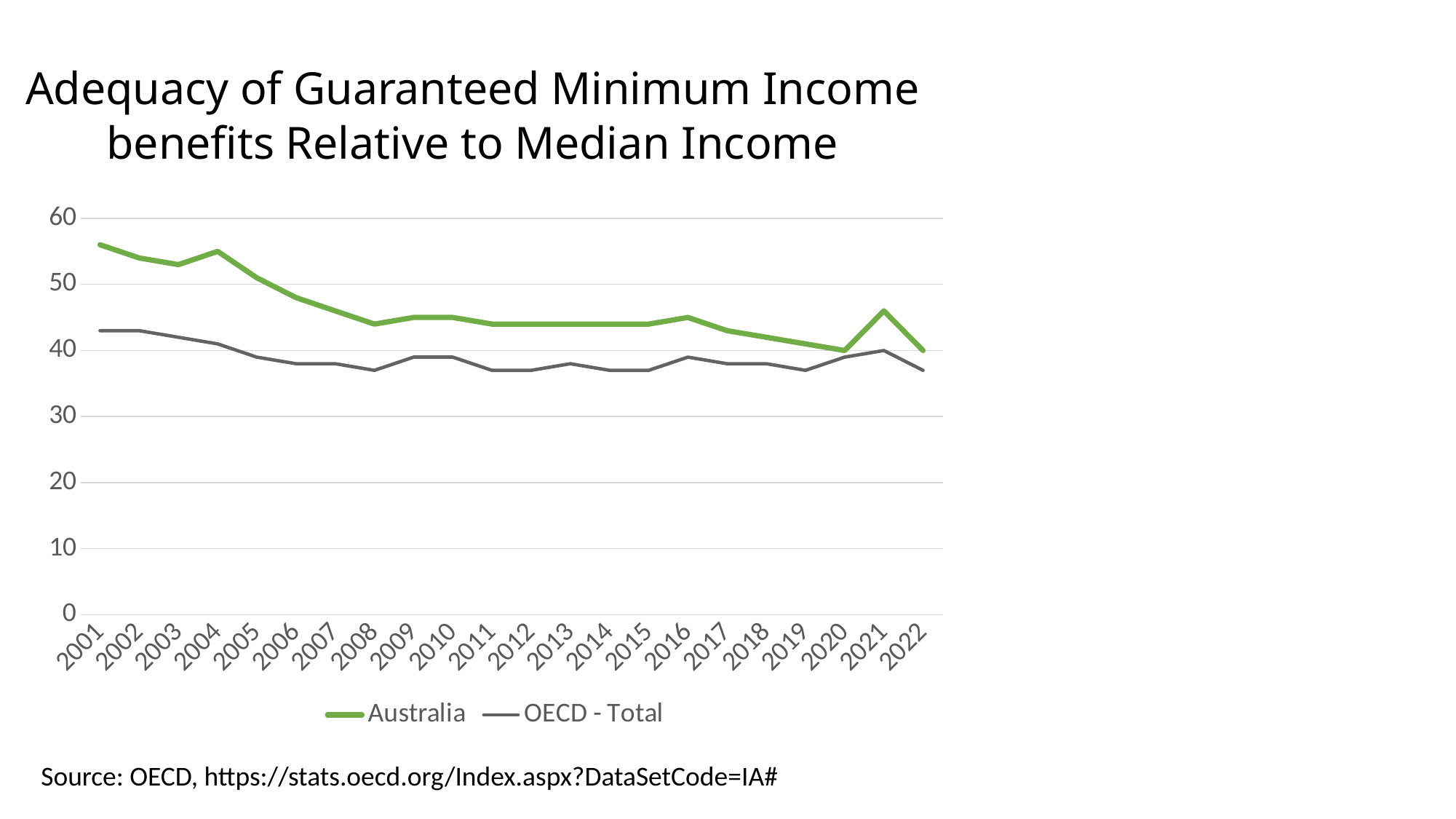
Is the value for OECD - Total in 2001 greater or less than 40? greater Is the value for Australia in 2001 greater or less than 50? greater What is the title of the chart? Adequacy of Guaranteed Minimum Income benefits Relative to Median Income What kind of chart is shown on the slide? line chart Which series is drawn in green? Australia How many years are plotted along the x axis? 22 Is the value for Australia in 2021 greater or less than 50? less In 2010, which series has the larger value, Australia or OECD - Total? Australia Does the Australia line overall rise or fall from 2001 to 2022? fall How many series does the legend list? 2 Which year has the highest value for Australia? 2001